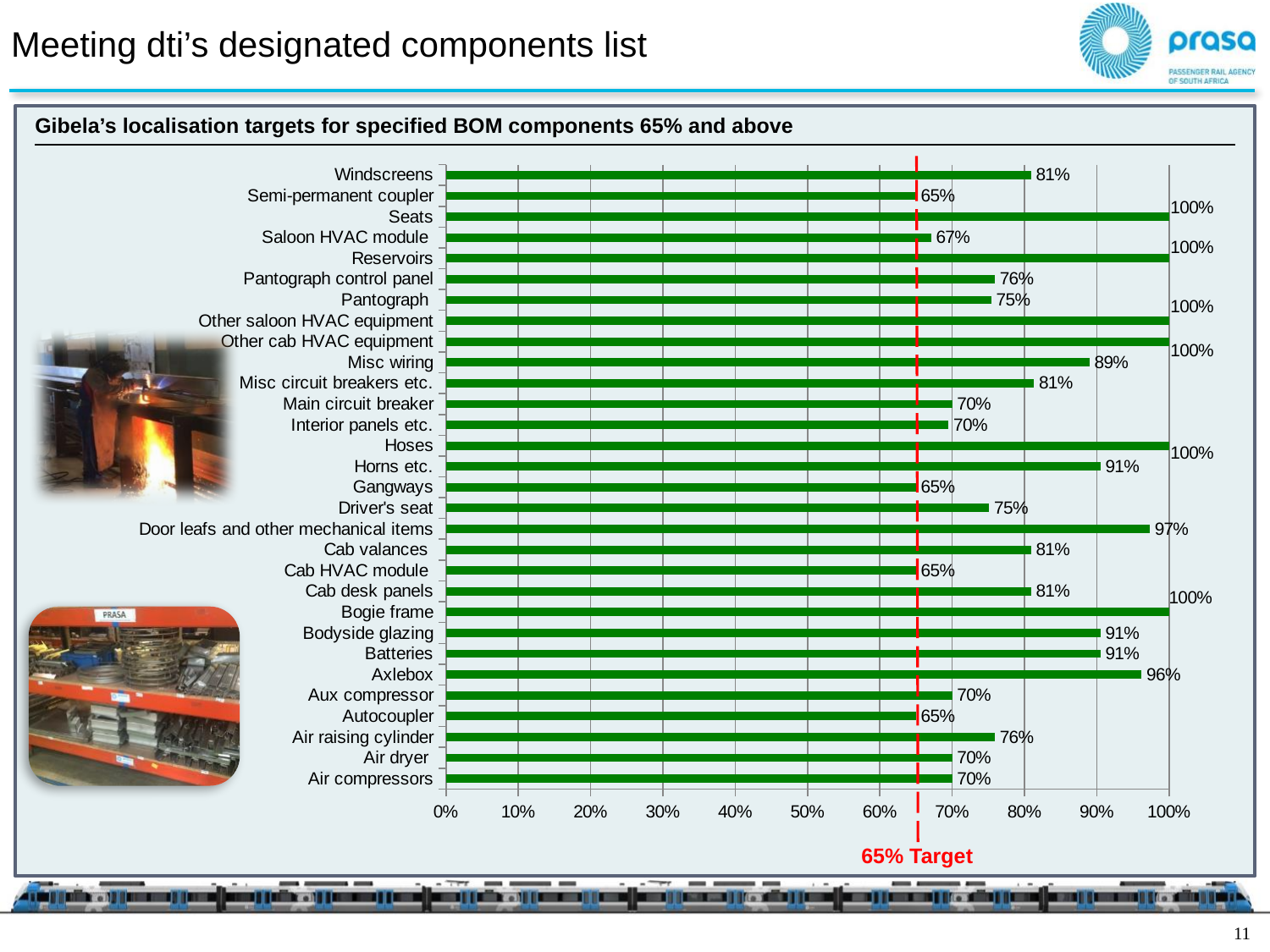
What is the localisation target for Door leafs and other mechanical items? 97% What is the difference between the localisation targets for Horns etc. and Gangways? 26% What is the localisation target for Axlebox? 96% How many components are listed on the chart? 30 What is the localisation target for Misc wiring? 89% Which has a higher localisation target, Bogie frame or Bodyside glazing? Bogie frame What value does the red dashed line on the chart mark? 65% Target What is the localisation target for Saloon HVAC module? 67% What is the localisation target for Windscreens? 81% What is the difference between the localisation targets for Axlebox and Air dryer? 26% Which has a higher localisation target, Pantograph control panel or Pantograph? Pantograph control panel What kind of chart is shown on the slide? Bar chart